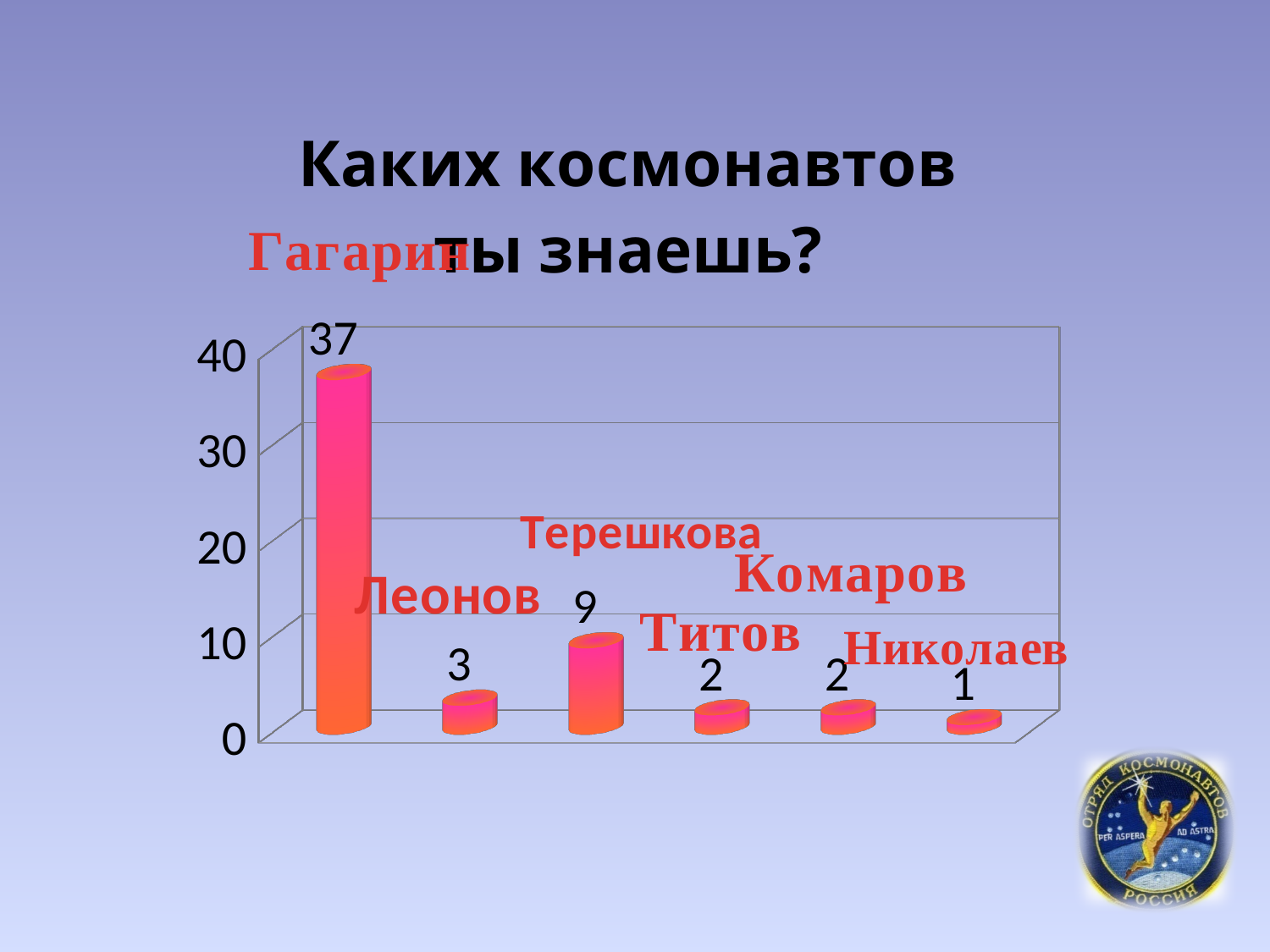
What is the difference between the values for Терешкова and Леонов? 6 What is the difference between the values for Гагарин and Терешкова? 28 Which cosmonaut has the highest value? Гагарин What kind of chart is shown on the slide? Bar chart Which cosmonaut has the lowest value? Николаев What value is shown for Терешкова? 9 What value is shown for Леонов? 3 How many cosmonauts are shown in the chart? 6 What is the title of the slide? Каких космонавтов ты знаешь? Which is larger, the value for Леонов or the value for Титов? Леонов What value is shown for Гагарин? 37 What value is shown for Николаев? 1